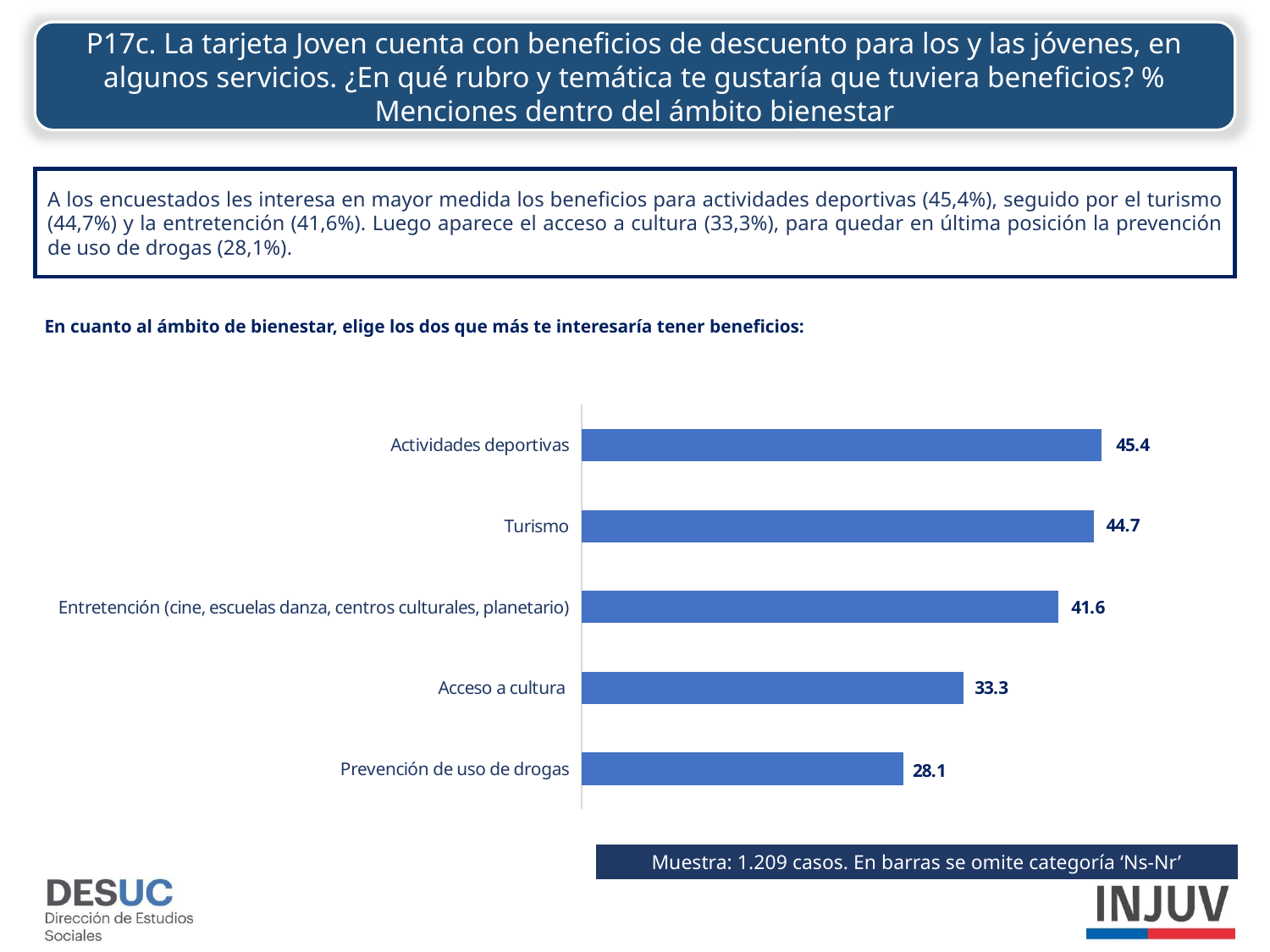
What is the value for Prevención de uso de drogas? 28.1 What kind of chart is shown on the slide? Bar chart What is the value for Actividades deportivas? 45.4 What is the sample size stated below the chart? 1.209 casos What is the difference between the values for Turismo and Acceso a cultura? 11.4 Which category has the highest value? Actividades deportivas Which category has the lowest value? Prevención de uso de drogas What is the difference between the values for Actividades deportivas and Prevención de uso de drogas? 17.3 Which is larger: the value for Entretención (cine, escuelas danza, centros culturales, planetario) or the value for Acceso a cultura? Entretención (cine, escuelas danza, centros culturales, planetario) How many categories are shown in the chart? 5 What is the value for Turismo? 44.7 What is the value for Acceso a cultura? 33.3